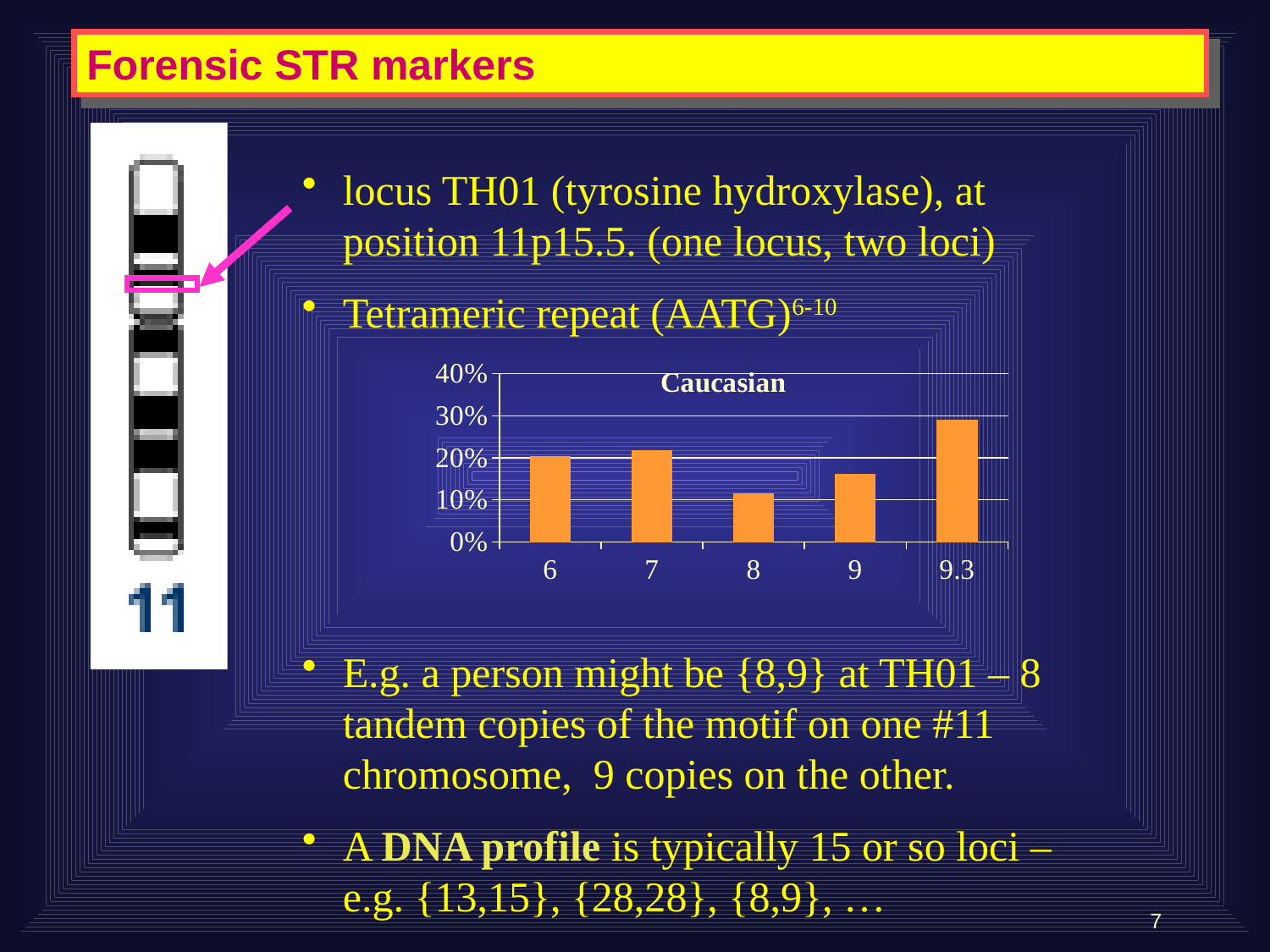
Which category has the highest bar in the chart? 9.3 Is the value for 9.3 greater or less than 40%? less Is the value for 9 greater or less than 20%? less What kind of chart is shown on the slide? bar chart How many categories are shown on the x axis of the chart? 5 Is the value for 8 greater or less than 20%? less What is the title of the chart? Caucasian Which has the larger value, category 9 or category 9.3? 9.3 Which category has the lowest bar in the chart? 8 Which has the larger value, category 7 or category 8? 7